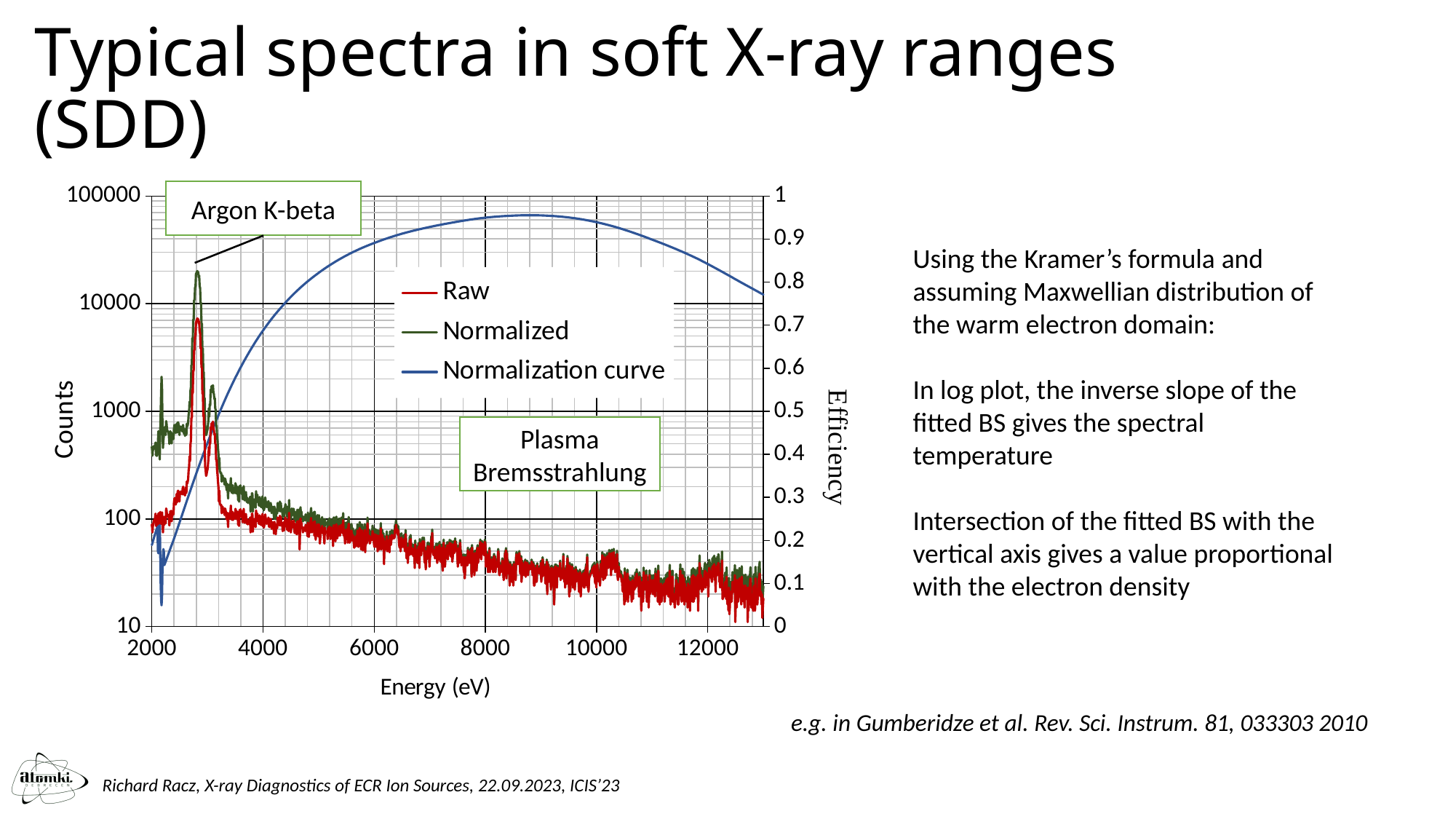
Is the Normalization curve value at 4000 eV greater or less than 0.5? greater What kind of chart is shown on the slide? line chart Is the Raw series value at 12000 eV greater or less than 100 counts? less Is the peak of the Normalized series near 3000 eV greater or less than 10000 counts? greater Do the Raw counts generally rise or fall as energy increases from 4000 eV to 12000 eV? fall At the peak near 3000 eV, which series is higher, Raw or Normalized? Normalized What is the label of the x axis of the chart? Energy (eV) Which series is drawn in blue in the chart? Normalization curve How many series does the chart legend list? 3